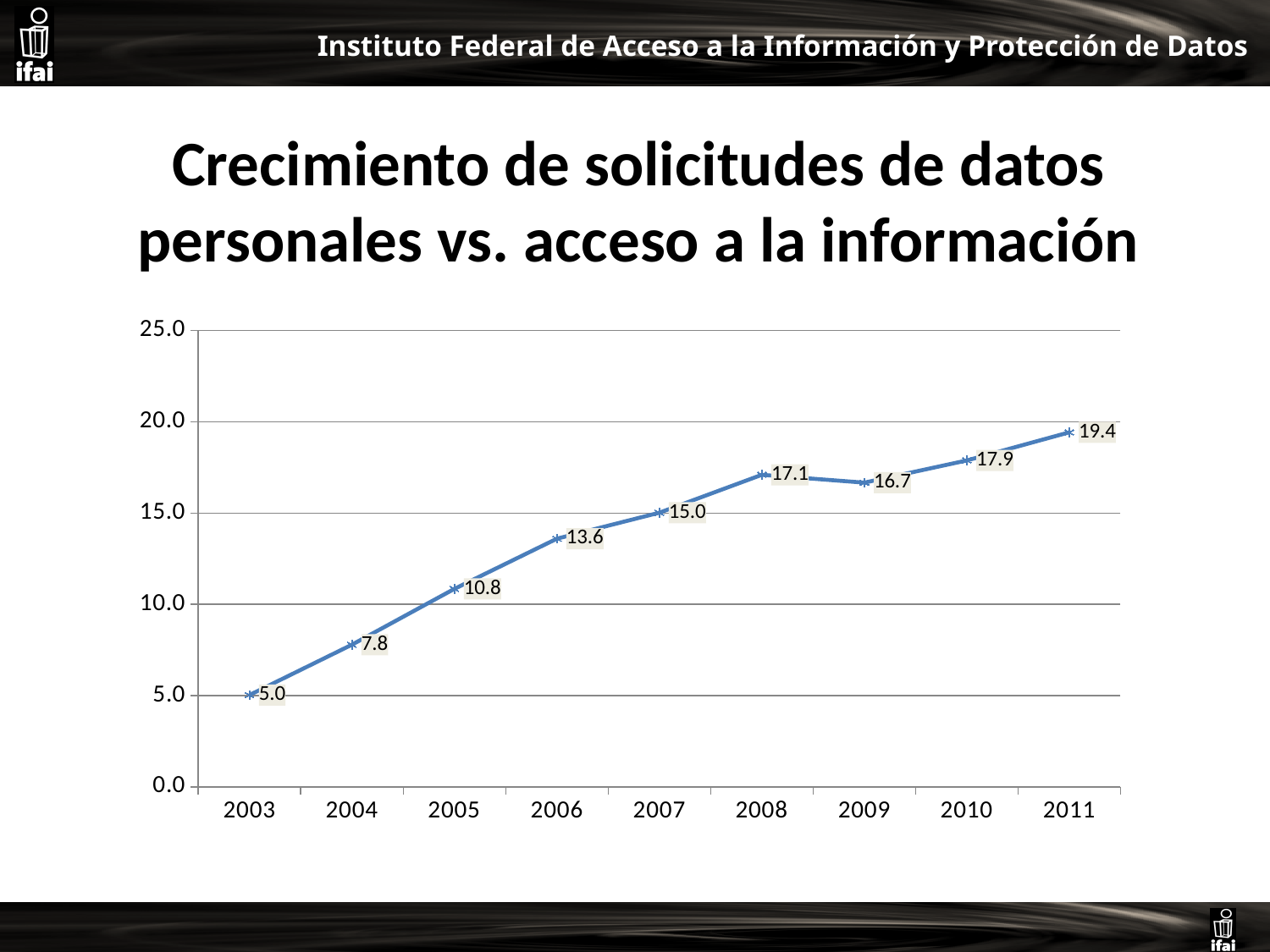
What kind of chart is shown on the slide? line chart Which is larger, the value for 2009 or the value for 2010? 2010 Is the value for 2006 greater or less than 15.0? less How many years are plotted on the chart? 9 What is the value for 2008? 17.1 What is the value for 2011? 19.4 Which year has the highest value? 2011 What is the difference between the values for 2008 and 2009? 0.4 What is the difference between the values for 2011 and 2003? 14.4 What is the value for 2003? 5.0 Do the values generally rise or fall from 2003 to 2011? rise Which year has the lowest value? 2003